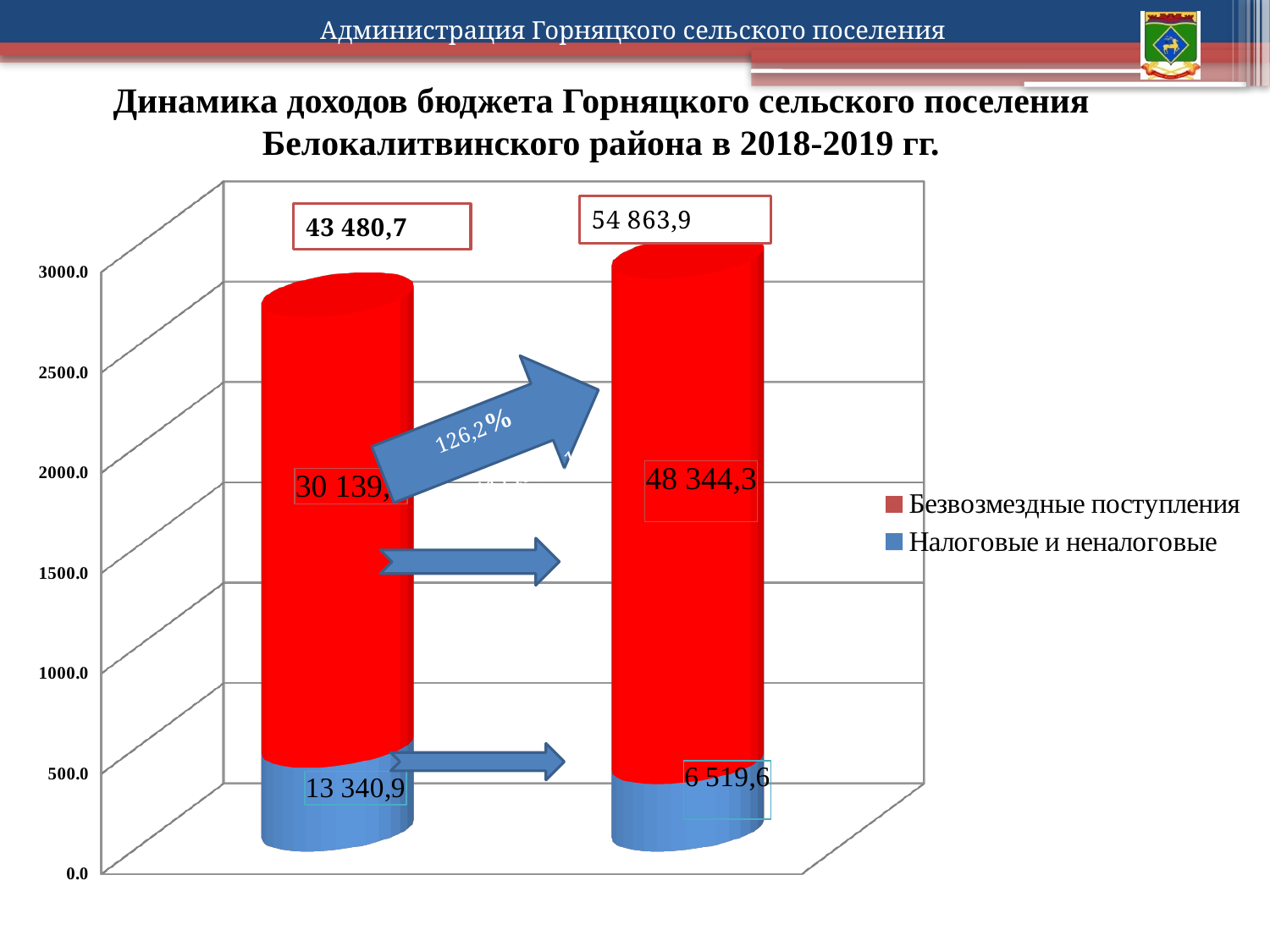
What is the value of Налоговые и неналоговые for the right bar? 6 519,6 How many stacked bars are plotted in the chart? 2 What is the value of Безвозмездные поступления for the right bar? 48 344,3 What kind of chart is shown on the slide? bar chart What is the total shown above the left stacked bar? 43 480,7 What percentage is written on the large diagonal arrow between the bars? 126,2% Do the bar totals rise or fall from the left bar to the right bar? rise How many series does the legend list? 2 What is the value of Налоговые и неналоговые for the left bar? 13 340,9 What is the difference between the Налоговые и неналоговые values of the left bar and the right bar? 6 821,3 What is the total shown above the right stacked bar? 54 863,9 Which bar has the larger value for Налоговые и неналоговые, the left or the right? left